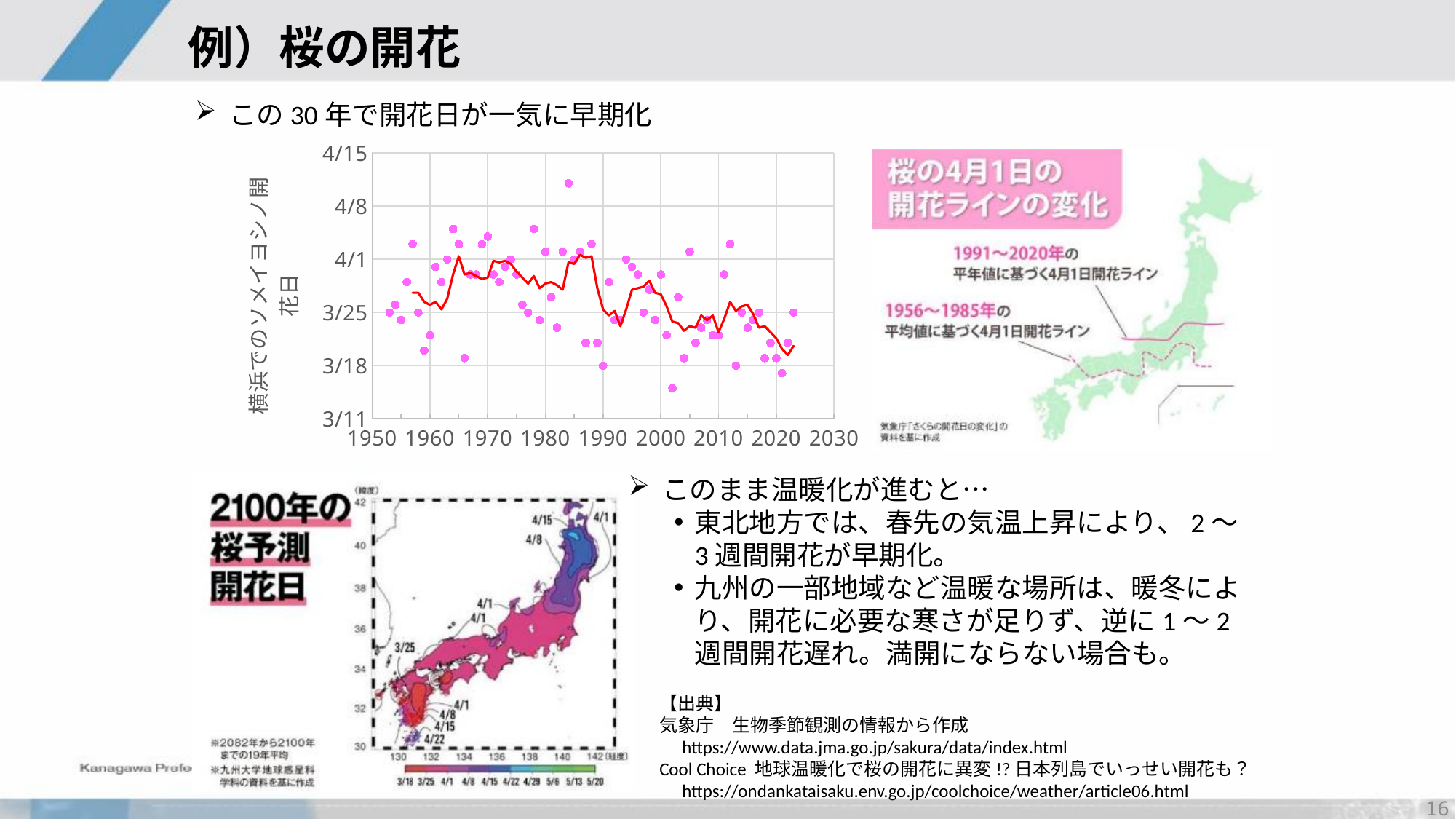
In the upper-left chart, which is later: the red trend line value around 1985 or around 2020? around 1985 What is the topmost tick label on the y axis of the upper-left chart? 4/15 In the upper-left chart, is the plotted point around 1983 (the highest one) later or earlier than 4/1? later In the upper-left chart, is the highest plotted point (around 1983) later or earlier than 4/8? later What is the first and last tick label on the x axis of the upper-left chart? 1950 and 2030 In the upper-left chart, is the red trend line around 1965 earlier or later than 3/25? later What kind of chart is the chart on the upper left of the slide (the one with the red line and pink dots)? scatter chart with a trend line In the upper-left chart, do the flowering dates generally rise or fall (become earlier) as the years increase along the x axis? fall (become earlier)